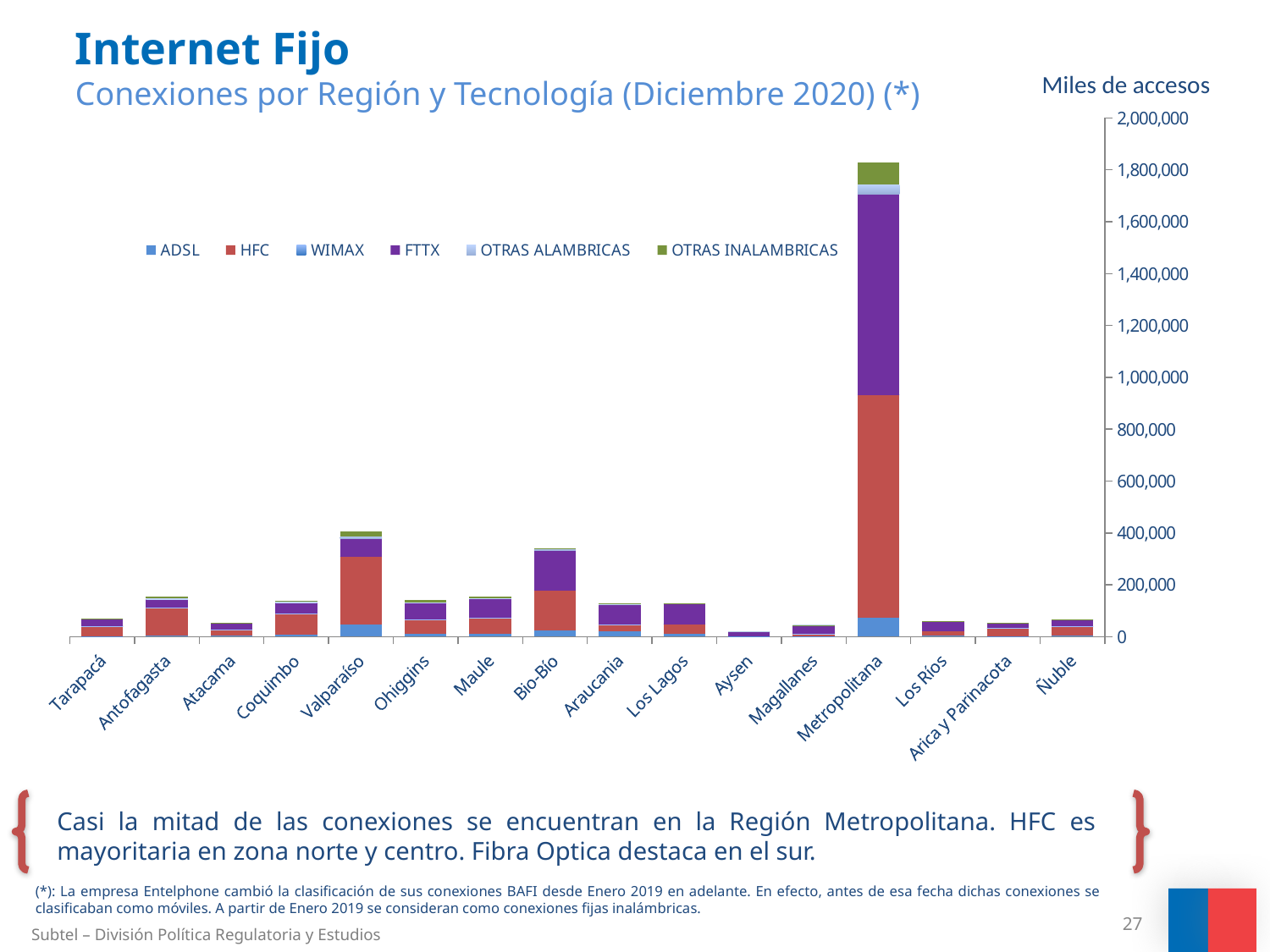
What unit label is shown above the chart's vertical axis? Miles de accesos What kind of chart is shown on the slide? Stacked bar chart Which region has a larger total, Valparaíso or Bio-Bío? Valparaíso Which region has the highest total number of connections? Metropolitana How many regions are shown along the x axis of the chart? 16 Is the total value for Bio-Bío greater or less than 200,000? greater Is the total value for Metropolitana greater or less than 1,600,000? greater Which technology is listed first in the chart's legend? ADSL Which region has the lowest total number of connections? Aysen Is the total value for Antofagasta greater or less than 200,000? less How many series does the chart's legend list? 6